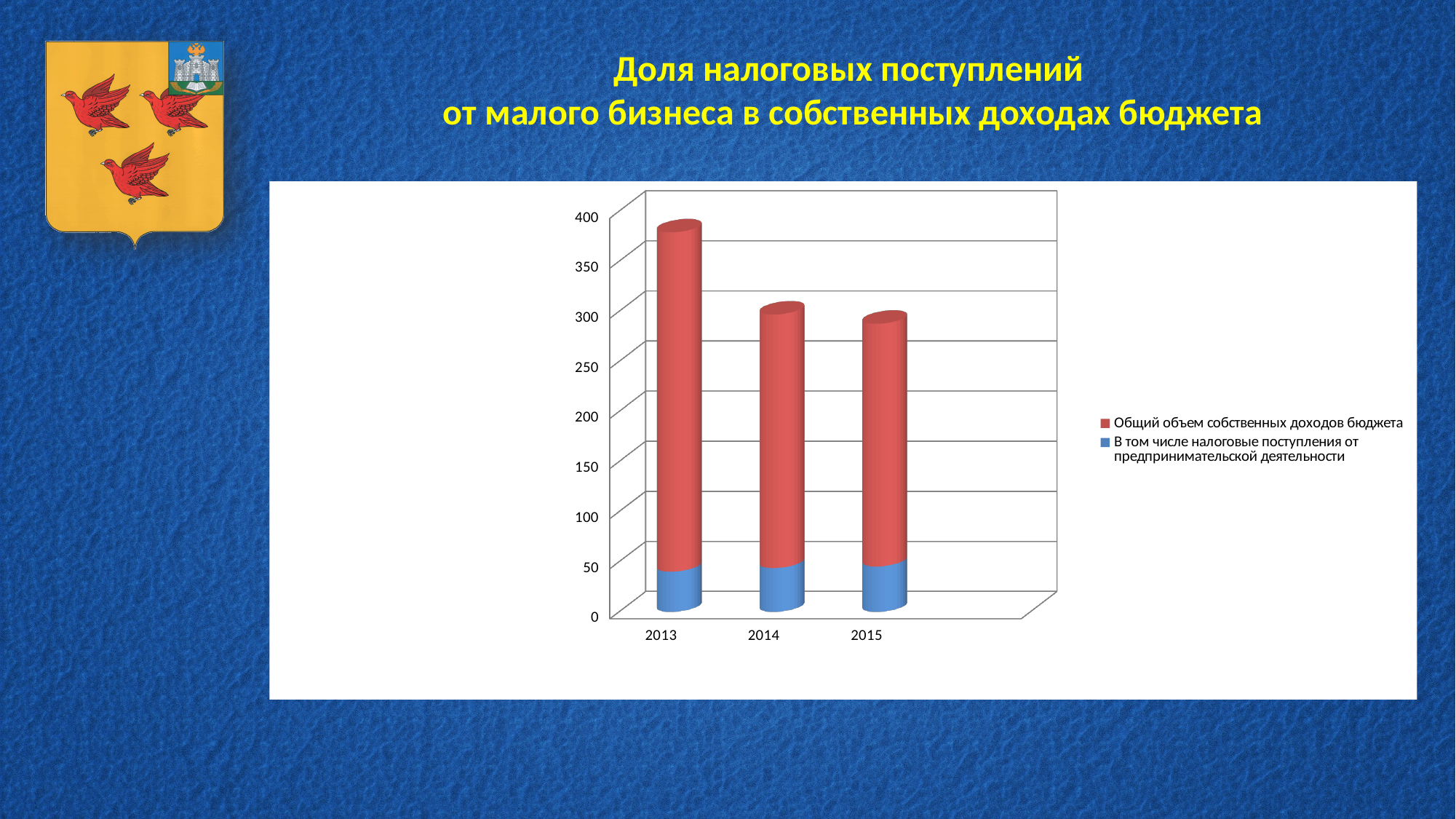
How many series does the chart legend list? 2 Do the total bar heights rise or fall from 2013 to 2015? fall Is the total bar for 2013 greater or less than 350? greater How many years are shown on the x axis of the chart? 3 Is the blue segment (налоговые поступления от предпринимательской деятельности) for 2013 greater or less than 100? less Is the total bar for 2014 greater or less than 250? greater Which year has the highest total bar in the chart? 2013 Which year has the larger total bar, 2013 or 2014? 2013 What kind of chart is shown on the slide? bar chart Which colour represents the series 'Общий объем собственных доходов бюджета' in the chart? red